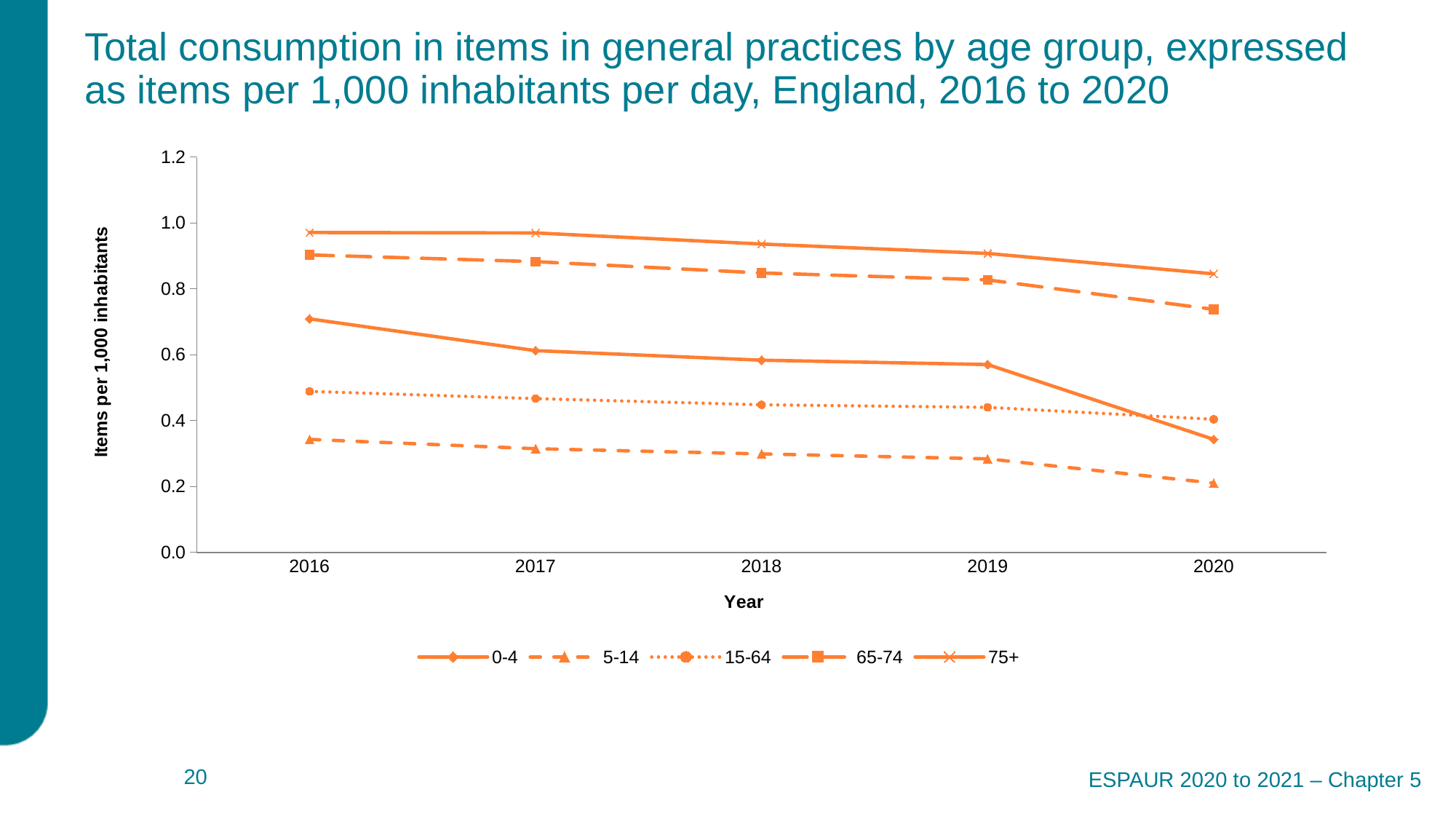
Is the value for the 65-74 age group in 2020 greater or less than 0.8? less How many age-group series does the legend list? 5 What kind of chart is shown on the slide? Line chart Is the value for the 0-4 age group in 2020 greater or less than 0.4? less In 2020, which is larger: the value for the 15-64 age group or the 0-4 age group? 15-64 Is the value for the 75+ age group in 2019 greater or less than 0.8? greater Which age group has the highest consumption in 2016? 75+ Which age group has the lowest consumption in 2020? 5-14 How many years are plotted along the x axis? 5 Do the values for the 0-4 age group rise or fall from 2016 to 2020? Fall What is the label on the y axis? Items per 1,000 inhabitants